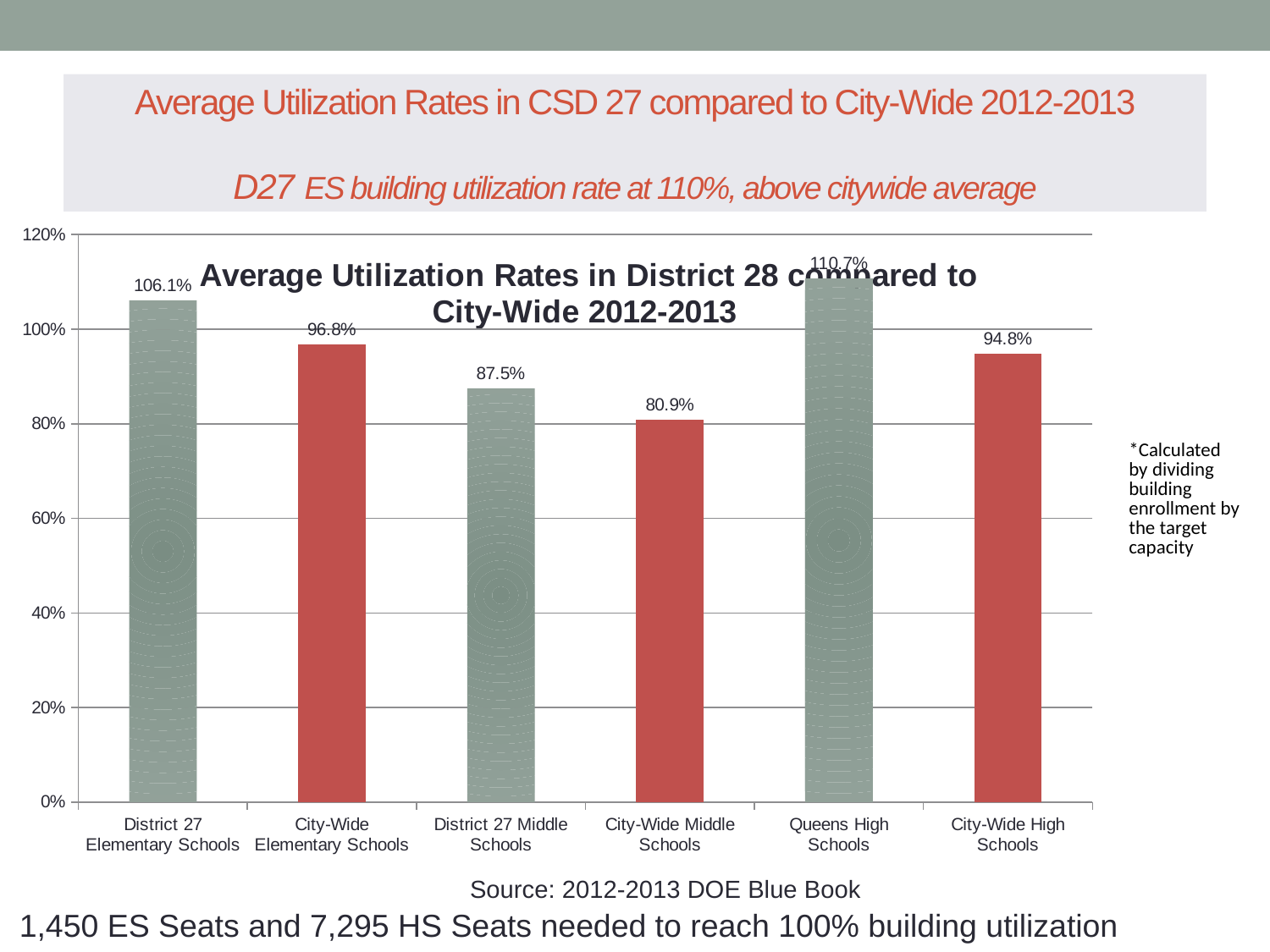
What is the difference between the utilization rates of District 27 Elementary Schools and City-Wide Elementary Schools? 9.3% Which has a higher utilization rate, Queens High Schools or City-Wide High Schools? Queens High Schools What is the utilization rate for District 27 Elementary Schools? 106.1% What is the utilization rate for City-Wide High Schools? 94.8% How many categories are shown on the x axis of the chart? 6 What type of chart is shown on the slide? Bar chart Which category has the highest utilization rate? Queens High Schools What is the utilization rate for Queens High Schools? 110.7% Which category has the lowest utilization rate? City-Wide Middle Schools Is the utilization rate for District 27 Middle Schools greater or less than 100%? less What is the difference between the utilization rates of District 27 Middle Schools and City-Wide Middle Schools? 6.6% What is the utilization rate for City-Wide Middle Schools? 80.9%